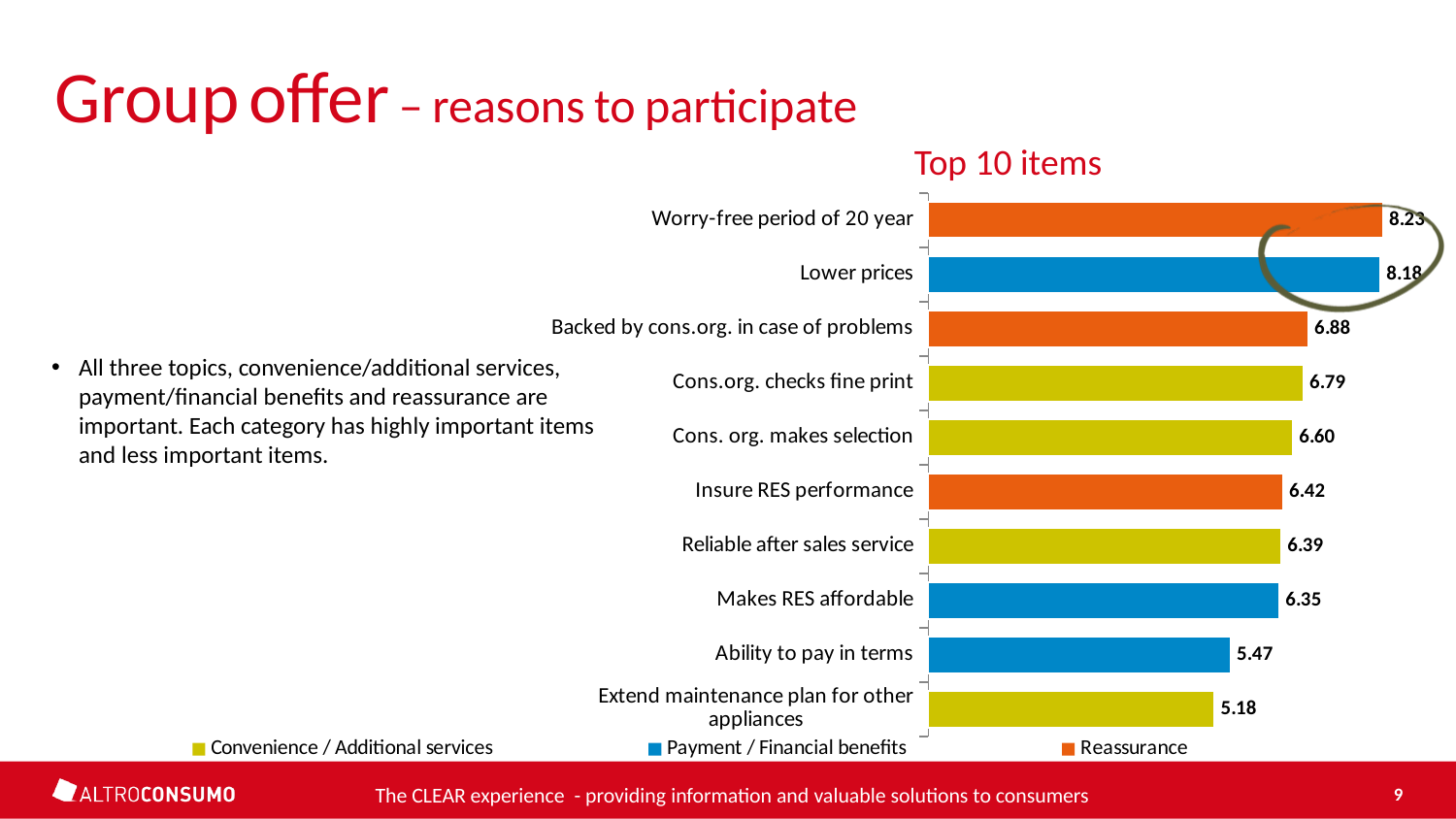
What is the difference between the values for "Worry-free period of 20 year" and "Lower prices"? 0.05 Which item has the highest value? Worry-free period of 20 year What is the value for "Backed by cons.org. in case of problems"? 6.88 Which item has the lowest value? Extend maintenance plan for other appliances What is the value for "Cons. org. makes selection"? 6.60 How many series does the legend list? 3 How many items are shown in the chart? 10 Which has a larger value, "Insure RES performance" or "Extend maintenance plan for other appliances"? Insure RES performance What kind of chart is shown on the slide? Bar chart What is the value for "Ability to pay in terms"? 5.47 Which series does the bar for "Lower prices" belong to, according to the legend colours? Payment / Financial benefits What is the difference between the values for "Makes RES affordable" and "Ability to pay in terms"? 0.88